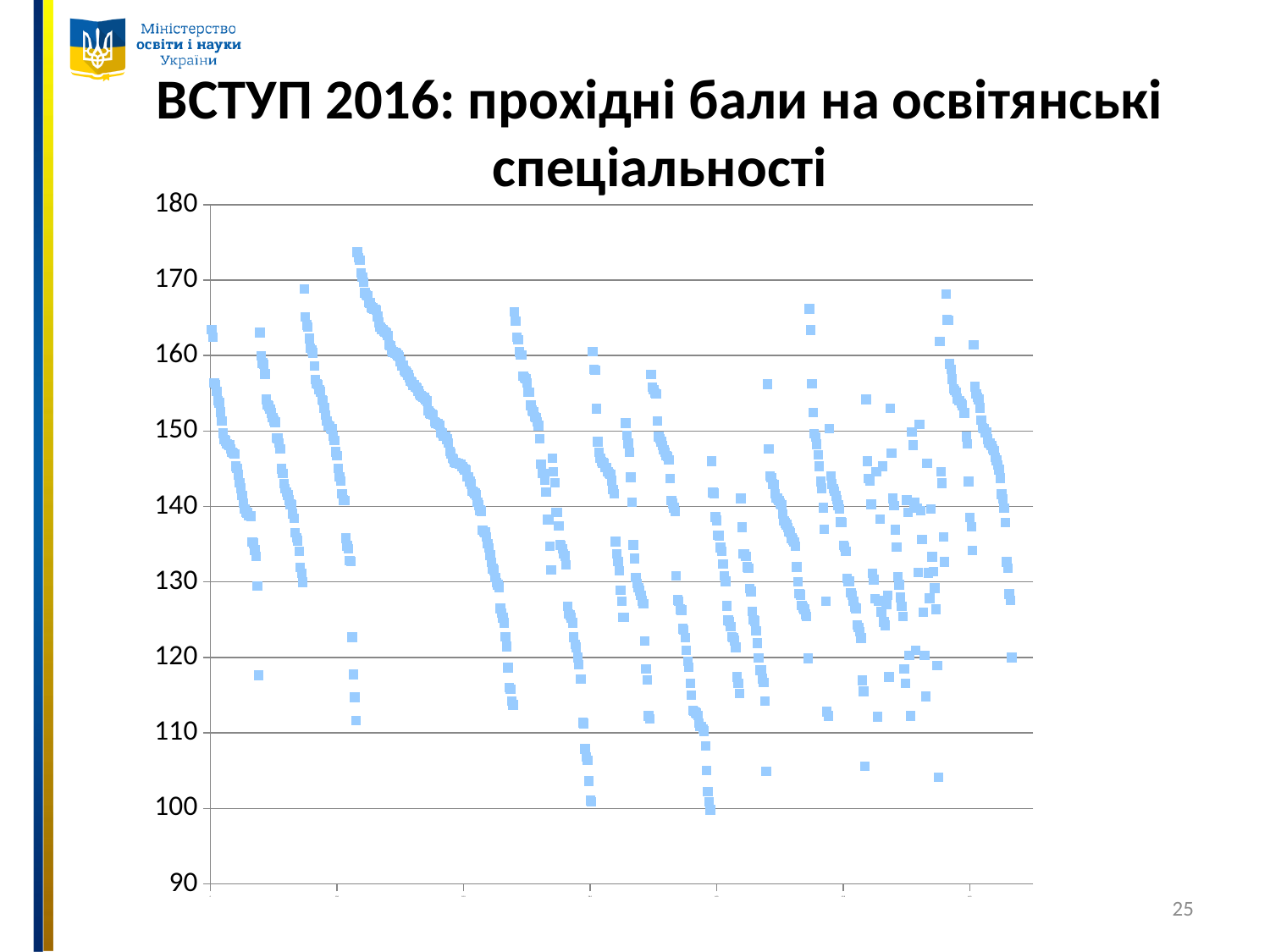
What is the highest value shown on the vertical axis of the chart? 180 Is the highest plotted point on the chart greater or less than 180? less What kind of chart is shown on the slide? scatter chart What is the title of the chart? ВСТУП 2016: прохідні бали на освітянські спеціальності Is the lowest plotted point on the chart greater or less than 90? greater Is the lowest plotted point on the chart greater or less than 110? less